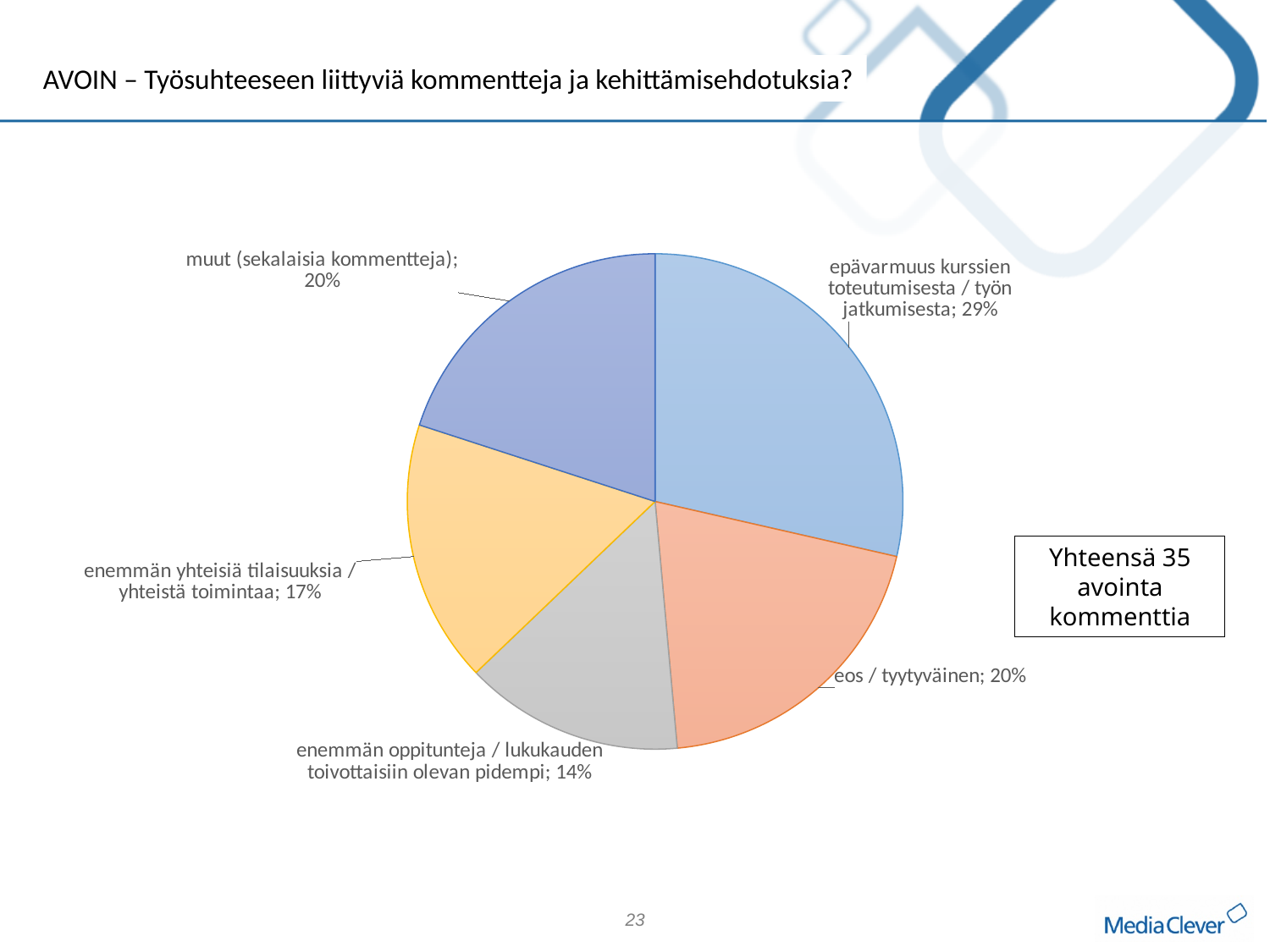
What kind of chart is shown on the slide? pie chart Which category has the smallest share of the pie? enemmän oppitunteja / lukukauden toivottaisiin olevan pidempi What share of the pie is 'muut (sekalaisia kommentteja)'? 20% What share of the pie is 'epävarmuus kurssien toteutumisesta / työn jatkumisesta'? 29% Which is larger: the share for 'enemmän yhteisiä tilaisuuksia / yhteistä toimintaa' or for 'enemmän oppitunteja / lukukauden toivottaisiin olevan pidempi'? enemmän yhteisiä tilaisuuksia / yhteistä toimintaa What share of the pie is 'eos / tyytyväinen'? 20% How many slices does the pie chart have? 5 What is the difference in percentage points between 'epävarmuus kurssien toteutumisesta / työn jatkumisesta' and 'enemmän yhteisiä tilaisuuksia / yhteistä toimintaa'? 12 percentage points According to the text box on the slide, how many open comments were there in total? 35 Which category has the largest share of the pie? epävarmuus kurssien toteutumisesta / työn jatkumisesta